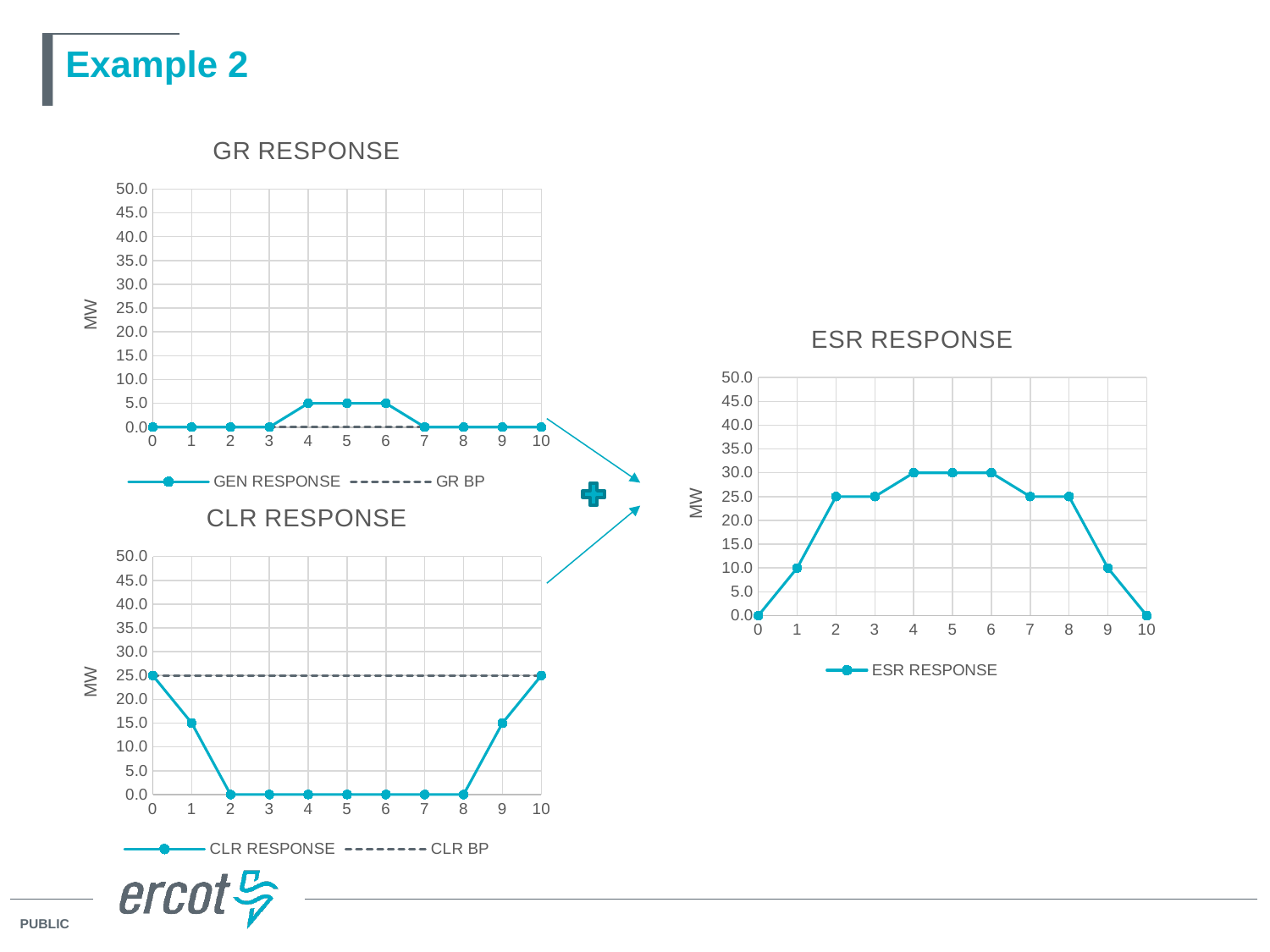
In the CLR RESPONSE chart, what is the CLR RESPONSE value at x = 0? 25.0 In the ESR RESPONSE chart, what is the ESR RESPONSE value at x = 1? 10.0 In the GR RESPONSE chart, what is the GEN RESPONSE value at x = 5? 5.0 In the ESR RESPONSE chart, what is the ESR RESPONSE value at x = 4? 30.0 In the CLR RESPONSE chart, at what MW level is the dashed CLR BP line drawn? 25.0 In the ESR RESPONSE chart, what is the difference between the ESR RESPONSE values at x = 5 and x = 2? 5.0 What kind of chart is the ESR RESPONSE chart? line chart In the ESR RESPONSE chart, which is larger: the ESR RESPONSE value at x = 6 or at x = 9? x = 6 In the ESR RESPONSE chart, is the ESR RESPONSE value at x = 4 greater or less than 20.0? greater In the CLR RESPONSE chart, what is the CLR RESPONSE value at x = 1? 15.0 In the GR RESPONSE chart, how many series does the legend list? 2 In the CLR RESPONSE chart, does the CLR RESPONSE line rise or fall between x = 0 and x = 2? fall